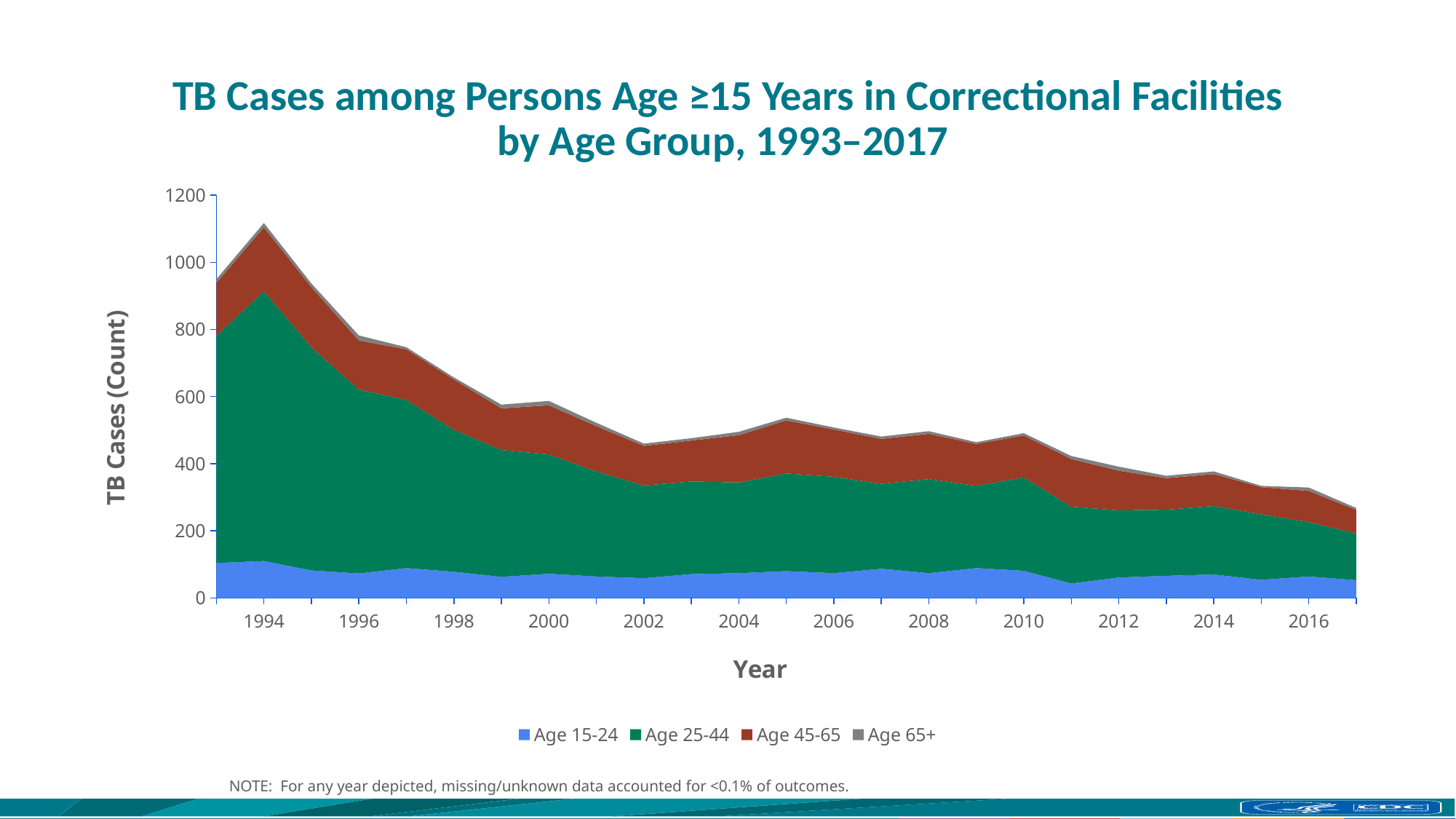
Is the total number of TB cases in 1994 greater or less than 1000? greater What are the four age groups listed in the legend? Age 15-24, Age 25-44, Age 45-65, Age 65+ Which age group accounts for the largest number of TB cases in 1994? Age 25-44 What kind of chart is shown on the slide? Stacked area chart In which year does the total number of TB cases reach its highest point? 1994 Which age group accounts for the smallest number of TB cases across the years shown? Age 65+ Is the total number of TB cases in 2002 greater or less than 600? less In 2017, which is larger: the number of cases for Age 25-44 or for Age 45-65? Age 25-44 Is the total number of TB cases in 2017 greater or less than 400? less What is the label on the vertical axis? TB Cases (Count) Overall, do total TB cases rise or fall from 1994 to 2017? fall How many series does the legend list? 4